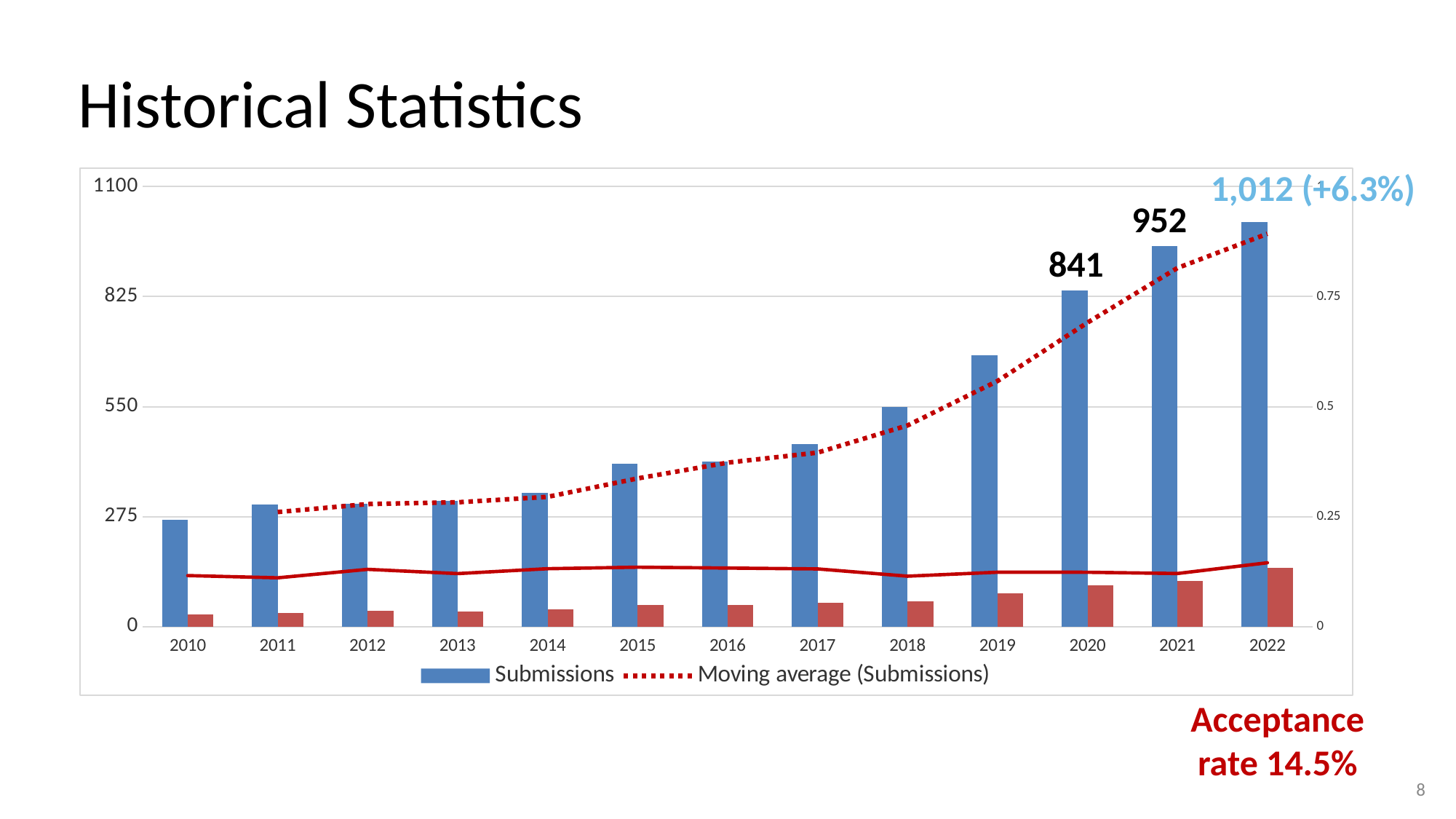
What percentage change is shown next to the 2022 Submissions label? +6.3% By how much did Submissions increase from 2020 to 2021? 111 How many series does the legend list? 2 Which year has the lowest number of Submissions? 2010 How many years are shown on the x axis? 13 What is the number of Submissions in 2022? 1,012 What is the number of Submissions in 2021? 952 Is the Submissions value for 2019 greater or less than 550? greater Which year has the highest number of Submissions? 2022 What is the number of Submissions in 2020? 841 By how much did Submissions increase from 2021 to 2022? 60 What is the overall trend of Submissions from 2010 to 2022? rising